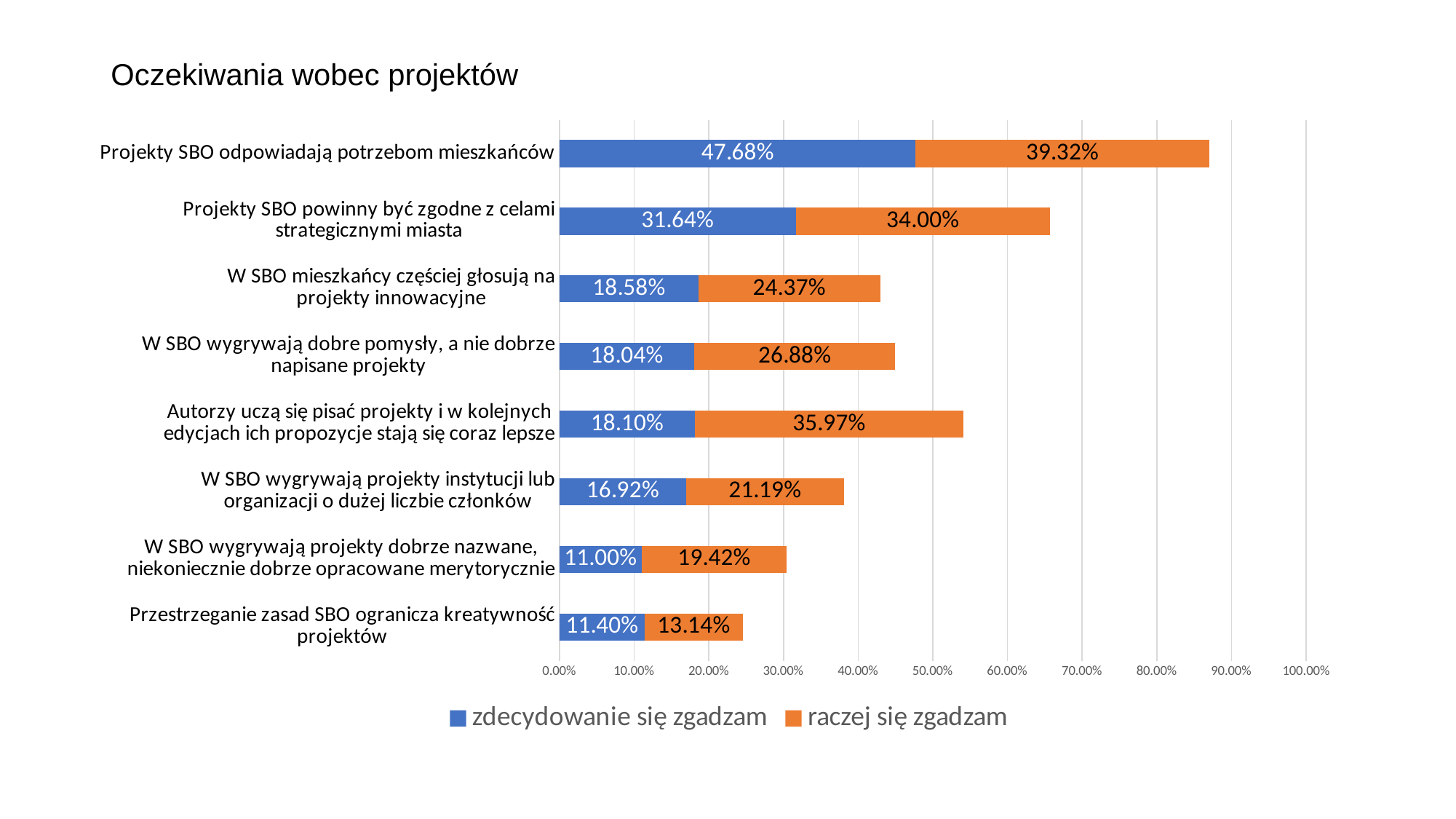
What is the 'zdecydowanie się zgadzam' value for 'Projekty SBO odpowiadają potrzebom mieszkańców'? 47.68% How many series does the legend list? 2 What is the title of the chart on the slide? Oczekiwania wobec projektów What is the total of the stacked bar for 'Projekty SBO powinny być zgodne z celami strategicznymi miasta'? 65.64% What kind of chart is shown on the slide? Stacked bar chart How many categories (statements) are plotted in the chart? 8 What is the 'raczej się zgadzam' value for 'Autorzy uczą się pisać projekty i w kolejnych edycjach ich propozycje stają się coraz lepsze'? 35.97% Which statement has the lowest 'raczej się zgadzam' value? Przestrzeganie zasad SBO ogranicza kreatywność projektów What is the difference between the 'raczej się zgadzam' values for 'Projekty SBO odpowiadają potrzebom mieszkańców' and 'Projekty SBO powinny być zgodne z celami strategicznymi miasta'? 5.32 percentage points Which is larger: the 'zdecydowanie się zgadzam' value for 'W SBO mieszkańcy częściej głosują na projekty innowacyjne' or for 'W SBO wygrywają dobre pomysły, a nie dobrze napisane projekty'? W SBO mieszkańcy częściej głosują na projekty innowacyjne What is the 'raczej się zgadzam' value for 'Przestrzeganie zasad SBO ogranicza kreatywność projektów'? 13.14% Which statement has the highest 'zdecydowanie się zgadzam' value? Projekty SBO odpowiadają potrzebom mieszkańców